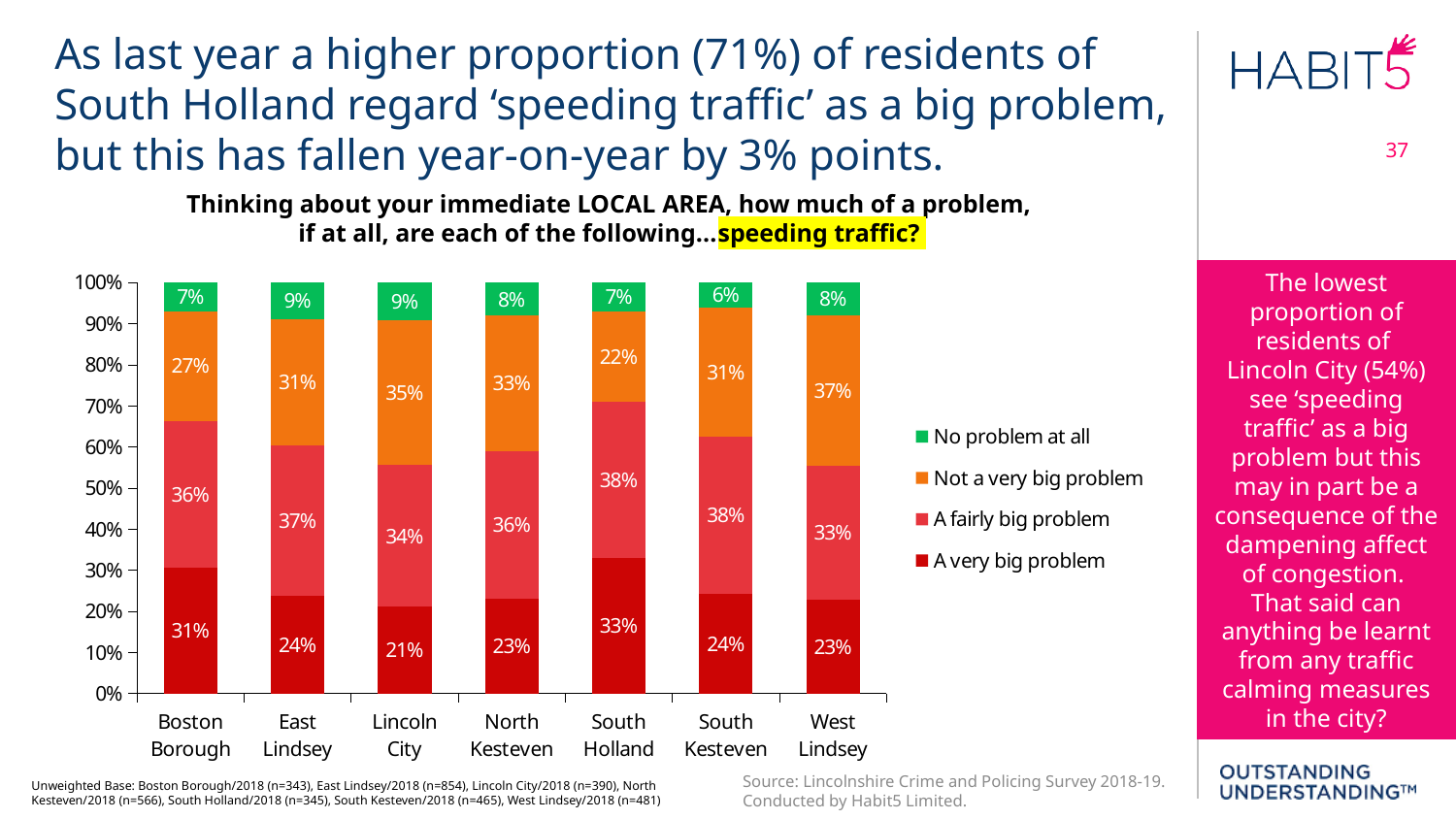
Which colour represents 'A very big problem' in the chart legend? Dark red How many areas are shown on the x axis of the chart? 7 Which area has the lowest 'A very big problem' percentage? Lincoln City Which area has the highest 'A very big problem' percentage? South Holland What is the difference between the 'A very big problem' values for South Holland and Lincoln City? 12% How many series does the chart legend list? 4 What percentage of Boston Borough residents say speeding traffic is 'A very big problem'? 31% What is the combined total of 'A very big problem' and 'A fairly big problem' for South Holland? 71% What is the 'No problem at all' value for South Kesteven? 6% What is the 'Not a very big problem' value for West Lindsey? 37% What kind of chart is shown on the slide? Stacked bar chart Which is larger: the 'Not a very big problem' value for Lincoln City or for Boston Borough? Lincoln City